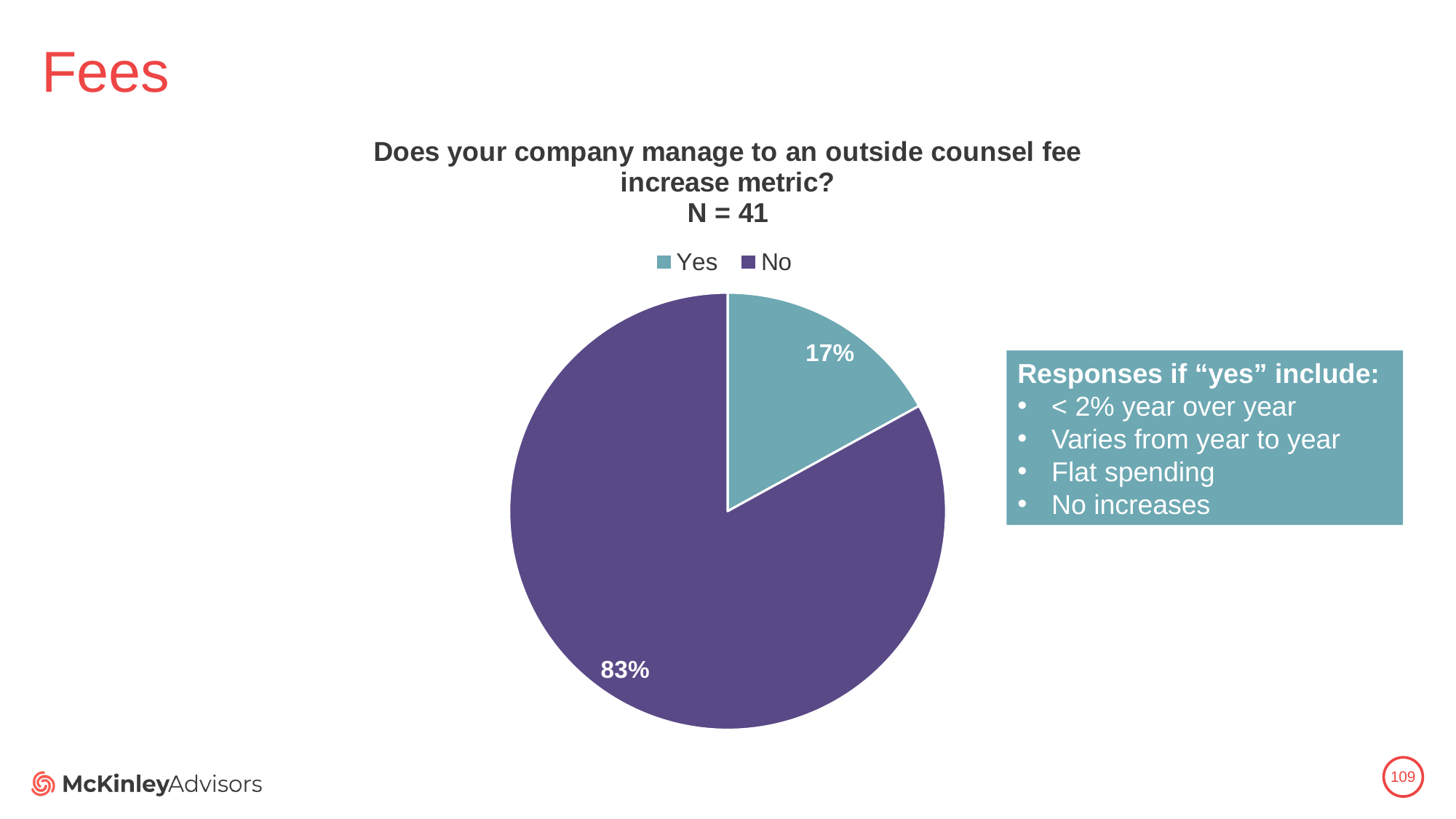
Which response has the smallest share of the pie? Yes Which slice is larger, "Yes" or "No"? No How many slices does the pie chart have? 2 How many entries does the legend list? 2 What is the difference in percentage points between the "No" and "Yes" slices? 66 Which colour represents the "No" response in the pie chart? Purple What percentage of respondents answered "Yes" to managing to an outside counsel fee increase metric? 17% What type of chart is shown on the slide? Pie chart What percentage of respondents answered "No" to managing to an outside counsel fee increase metric? 83% Which response has the largest share of the pie? No What is the sample size (N) shown in the chart title? 41 What share of the pie does the "Yes" slice represent? 17%